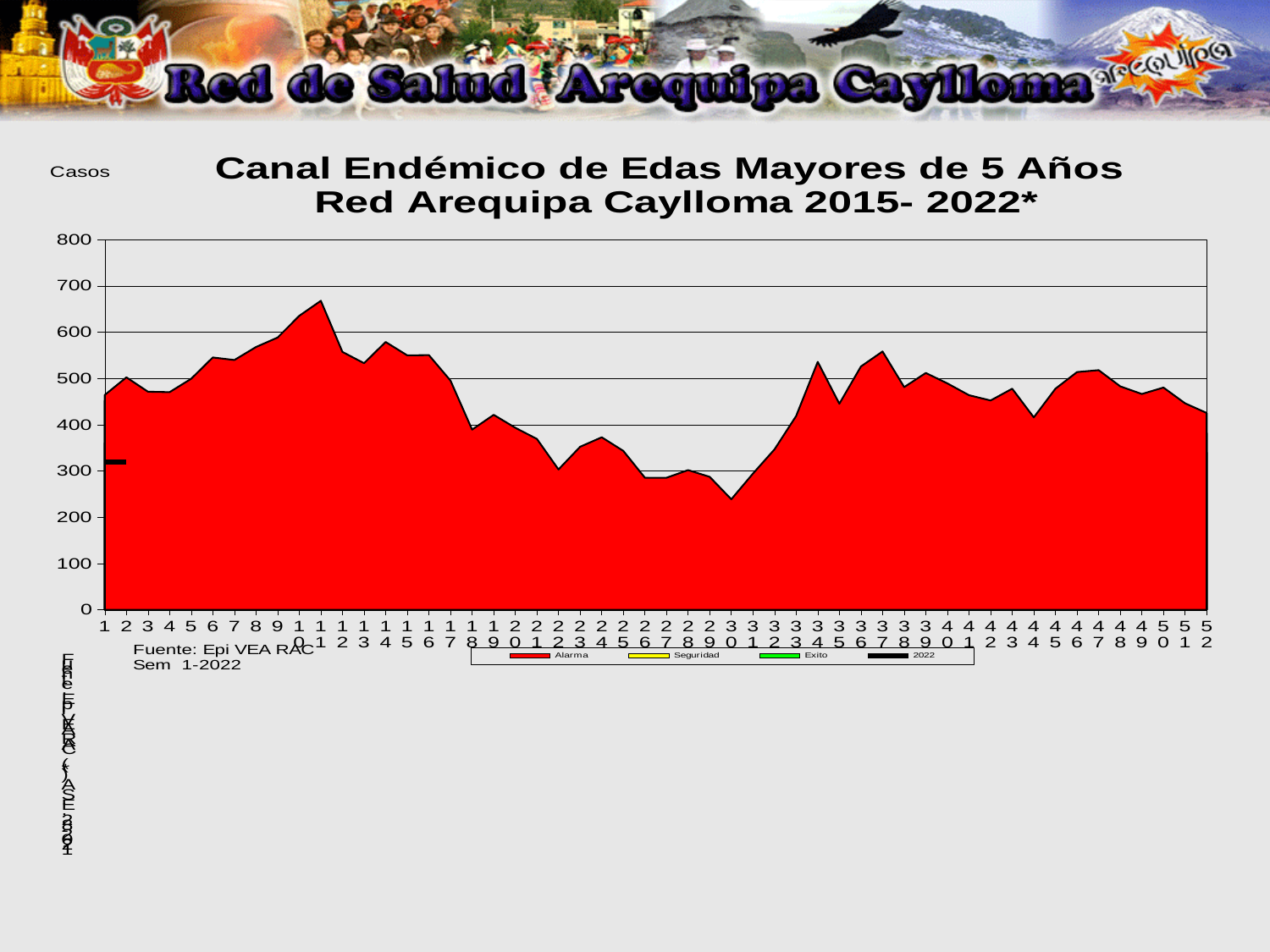
Is the Alarma value at week 1 greater or less than 400? greater What are the four entries in the chart legend? Alarma, Seguridad, Exito, 2022 At which week does the Alarma series reach its highest value? Week 11 What is the title of the chart? Canal Endémico de Edas Mayores de 5 Años Red Arequipa Caylloma 2015- 2022* How many weeks are shown along the x axis of the chart? 52 At which week does the Alarma series reach its lowest value? Week 30 Which is larger, the Alarma value at week 11 or at week 30? Week 11 Do the Alarma values rise or fall from week 11 to week 30? Fall How many series does the chart legend list? 4 Is the Alarma value at week 11 greater or less than 600? greater Is the Alarma value at week 30 greater or less than 300? less What kind of chart is shown on the slide? Area chart